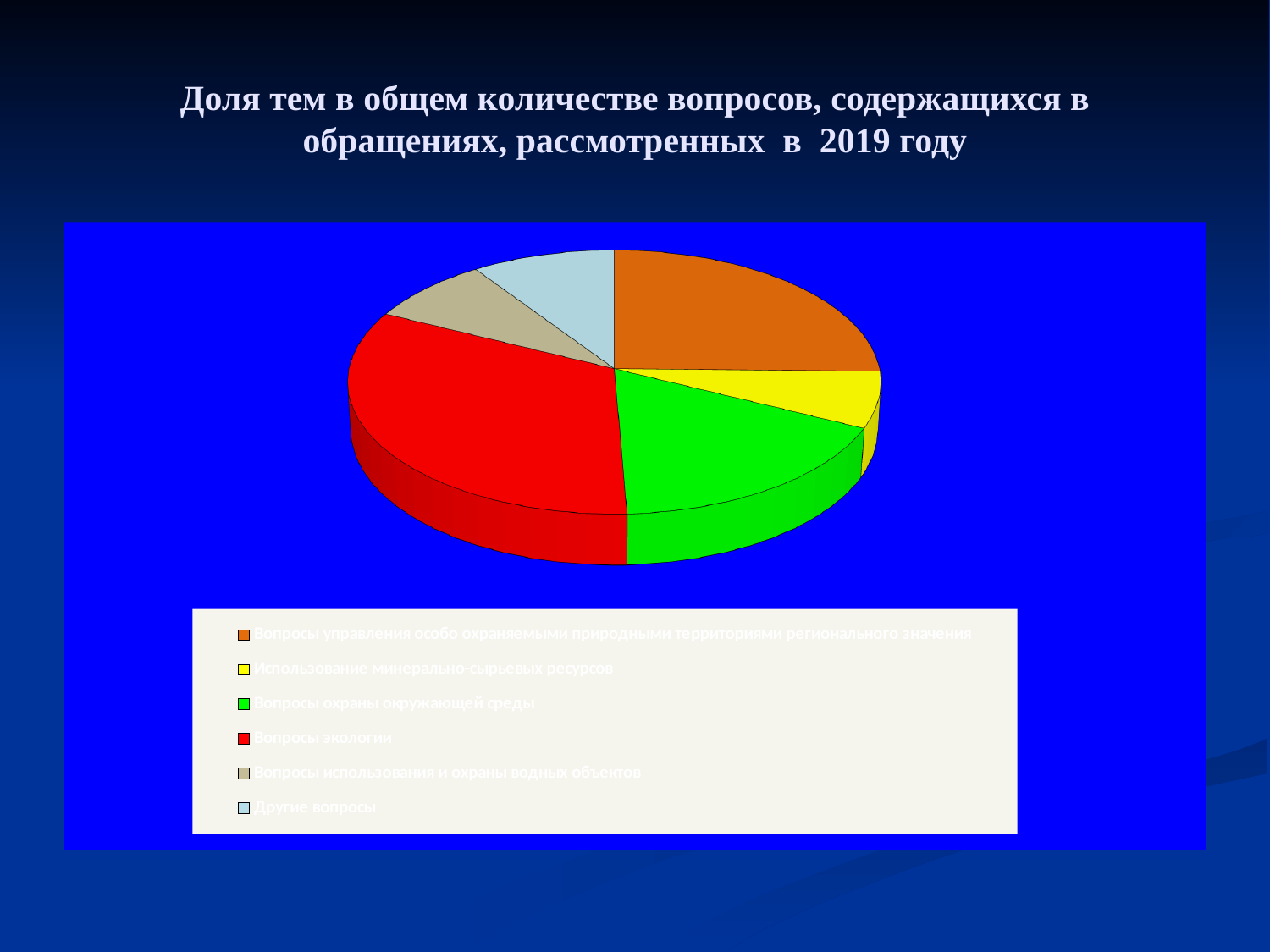
Which slice is larger: Вопросы экологии or Вопросы управления особо охраняемыми природными территориями регионального значения? Вопросы экологии What kind of chart is shown on the slide? pie chart What colour represents Вопросы экологии in the legend? red Which slice is larger: Вопросы экологии or Другие вопросы? Вопросы экологии How many slices does the pie chart have? 6 Which slice is larger: Вопросы охраны окружающей среды or Использование минерально-сырьевых ресурсов? Вопросы охраны окружающей среды Which category has the largest slice of the pie? Вопросы экологии What is the title of the chart on the slide? Доля тем в общем количестве вопросов, содержащихся в обращениях, рассмотренных в 2019 году